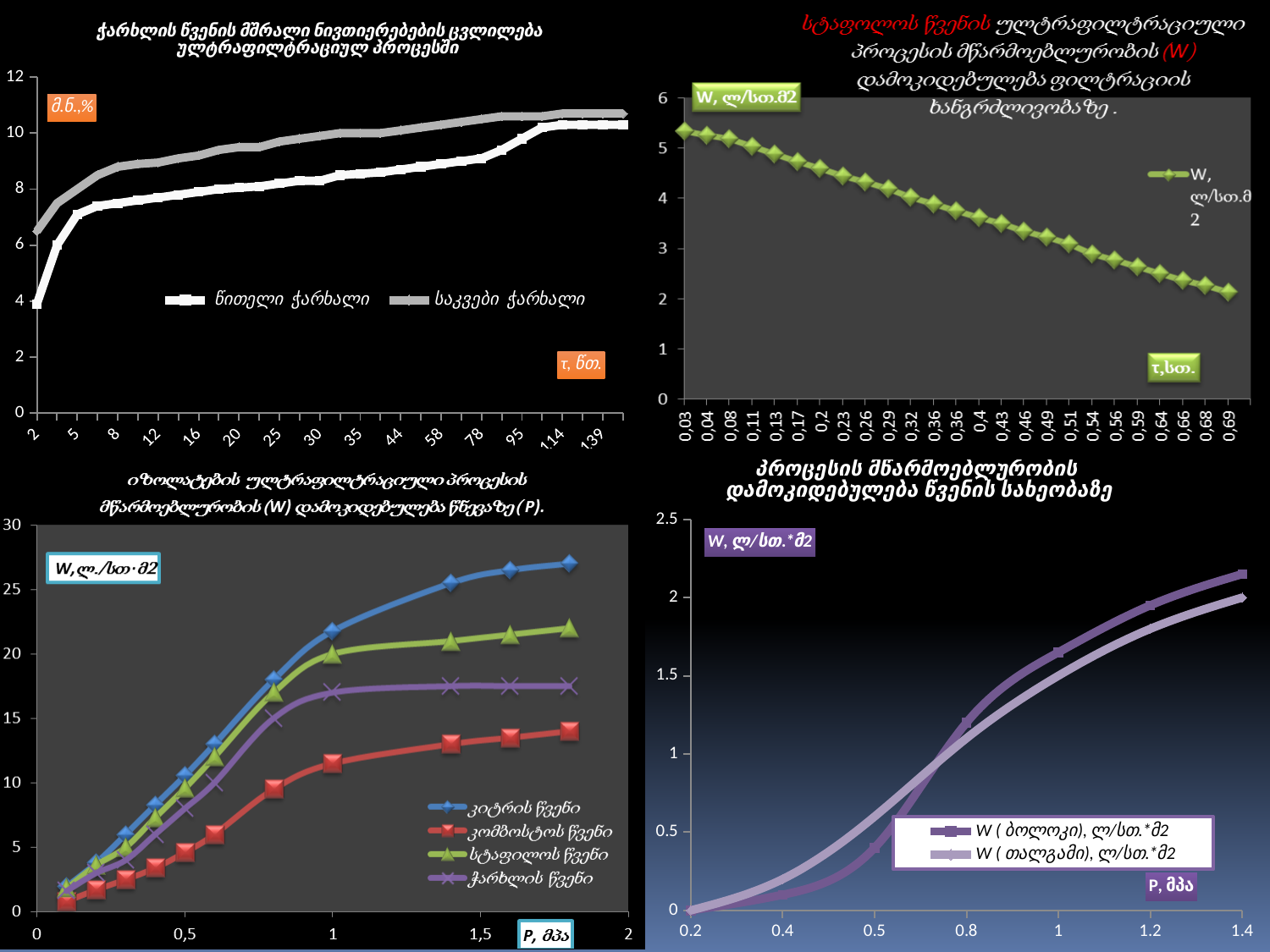
In the top-right chart, is the value of W at τ = 0,03 greater or less than 5? greater In the bottom-right chart, which series has the higher value at P = 0.5, W (ბოლოკი) or W (თალგამი)? W (თალგამი) How many series does the legend of the bottom-left chart list? 4 In the bottom-left chart, which series has the lowest values? კომბოსტოს წვენი In the top-right chart, is the value of W at τ = 0,69 greater or less than 3? less In the top-left chart, do the values rise or fall along the x axis? rise What type of chart is the top-left chart? line chart In the top-left chart, which series has the higher values, წითელი ჭარხალი or საკვები ჭარხალი? საკვები ჭარხალი How many series does the legend of the top-left chart list? 2 In the top-right chart, do the values of W rise or fall as τ increases? fall In the bottom-left chart, which series reaches the highest values? კიტრის წვენი How many series does the legend of the bottom-right chart list? 2